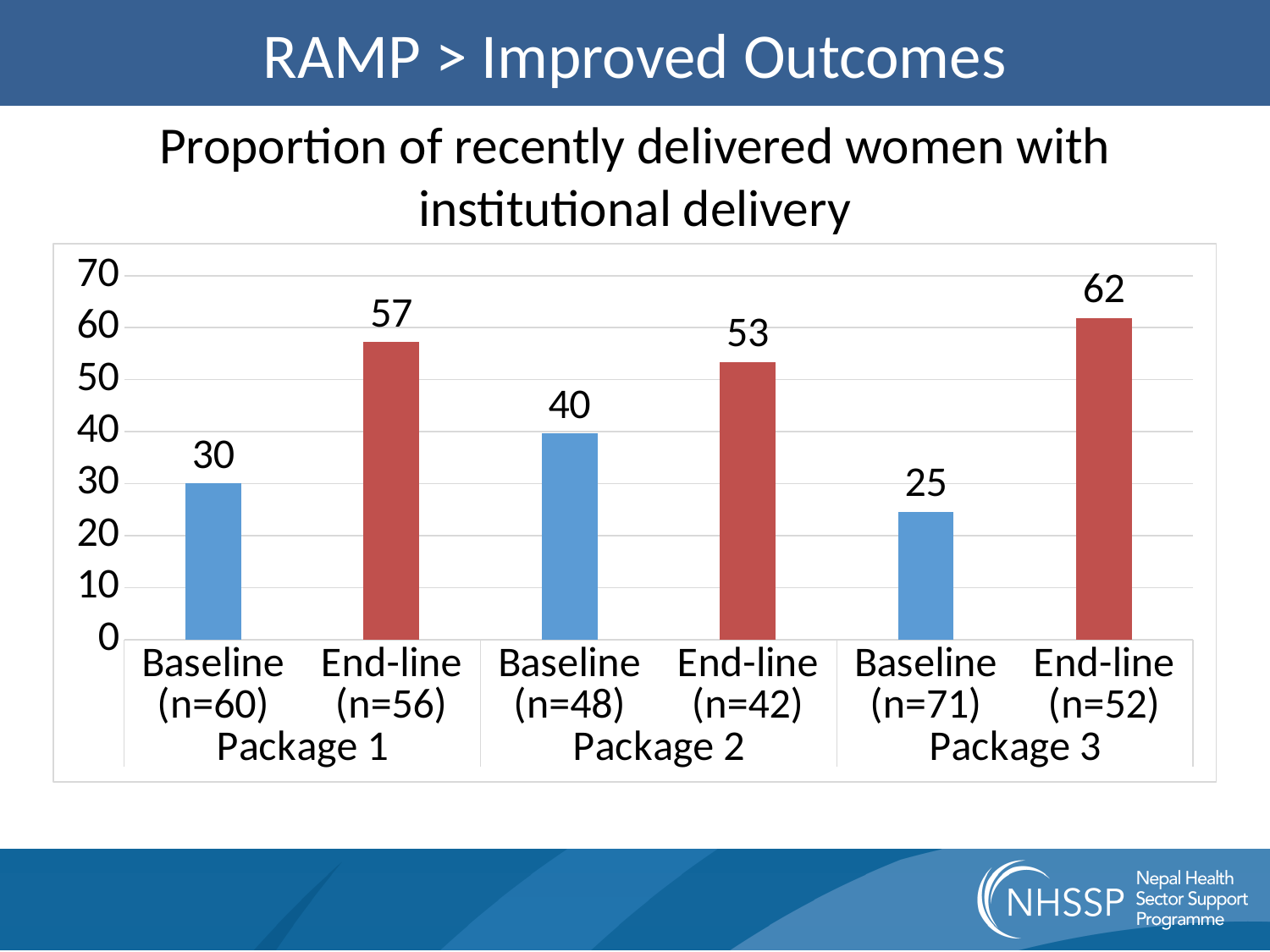
What kind of chart is shown on the slide? Bar chart What is the value for Baseline (n=60) in Package 1? 30 What is the value for End-line (n=52) in Package 3? 62 What is the title of the chart? Proportion of recently delivered women with institutional delivery What is the value for Baseline (n=48) in Package 2? 40 Which is larger, the Baseline value in Package 2 or the Baseline value in Package 1? Baseline in Package 2 Which bar has the highest value? End-line (n=52), Package 3 How many bars are plotted in the chart? 6 What is the value for End-line (n=56) in Package 1? 57 What is the difference between the End-line and Baseline values in Package 2? 13 What is the difference between the End-line and Baseline values in Package 3? 37 Which bar has the lowest value? Baseline (n=71), Package 3